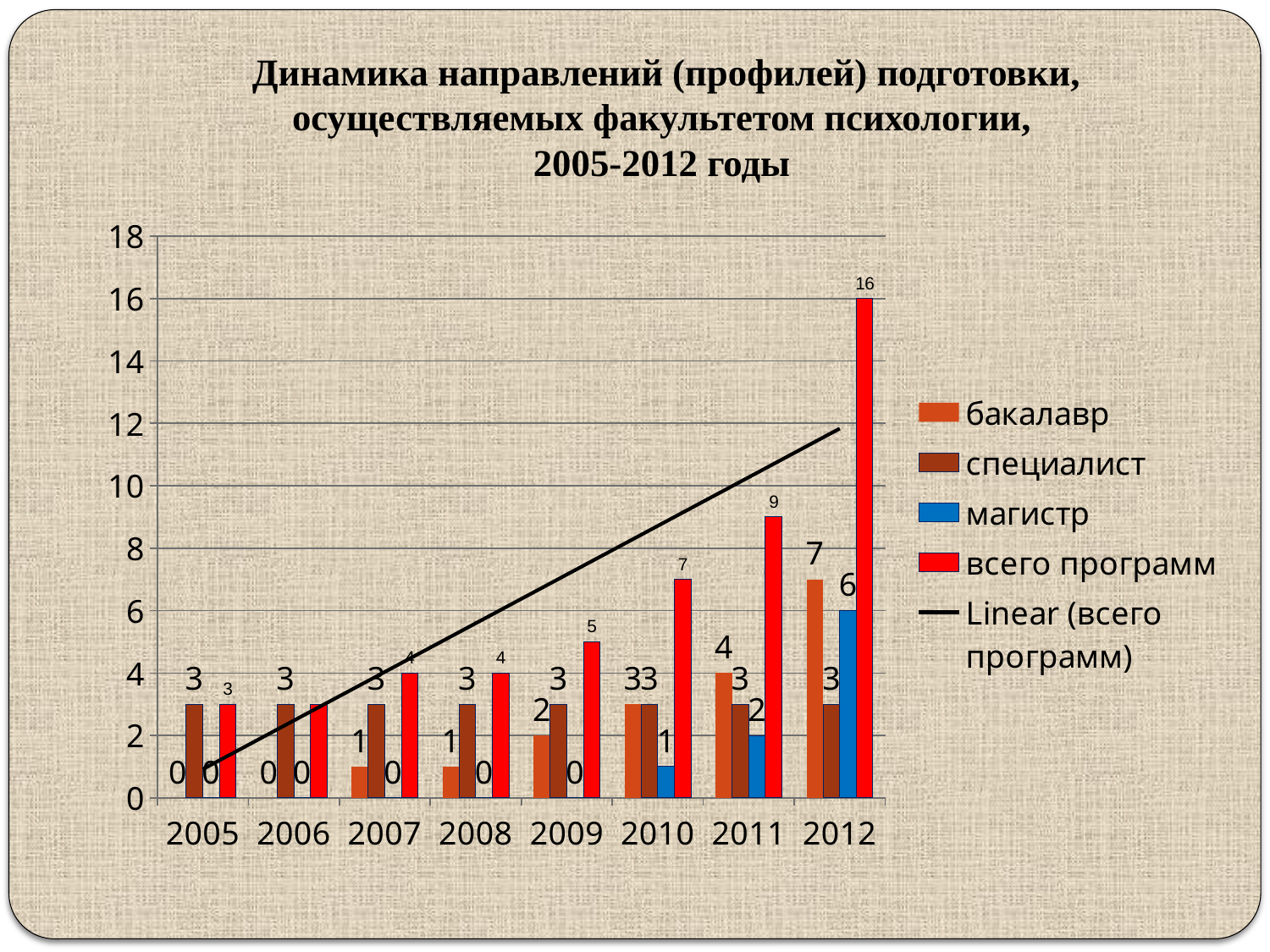
What kind of chart is this? bar chart Which is larger in 2012: бакалавр or магистр? бакалавр What is the value of специалист in 2009? 3 What is the value of бакалавр in 2011? 4 What is the value of магистр in 2012? 6 In which year is бакалавр lowest (tied years allowed)? 2005 and 2006 In which year is всего программ highest? 2012 Does всего программ rise or fall from 2005 to 2012? rise How many years are shown on the x axis? 8 How many entries does the legend list? 5 What is the difference between всего программ in 2012 and in 2011? 7 What is the value of всего программ in 2012? 16